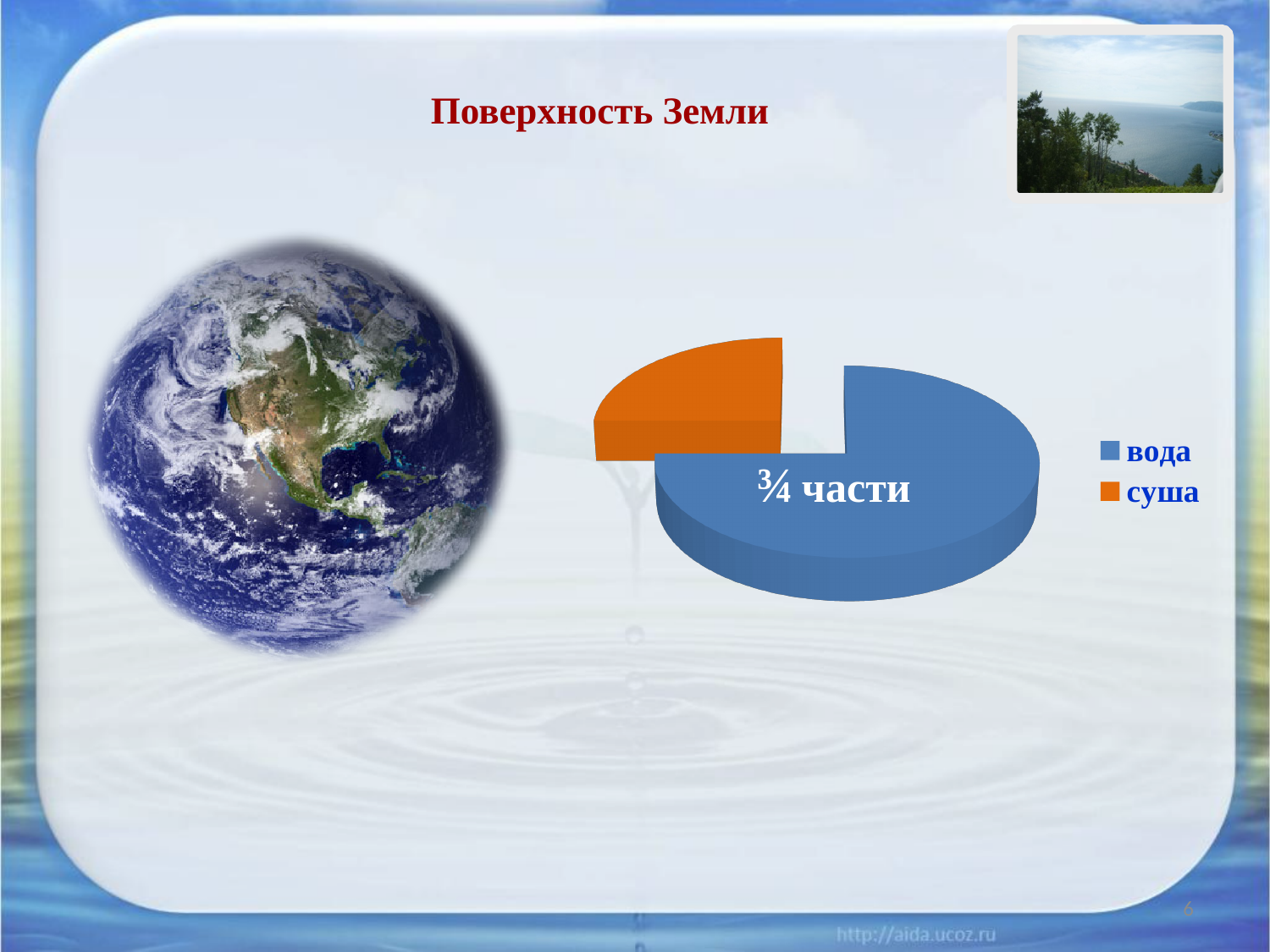
What kind of chart is shown on the slide? pie chart What colour is the суша slice in the pie chart? orange Which category has the smallest slice in the pie chart? суша How many entries does the legend of the pie chart list? 2 Which slice is larger in the pie chart, вода or суша? вода Which category has the largest slice in the pie chart? вода How many slices does the pie chart have? 2 What share of the pie does the вода slice represent, according to the label on the slide? ¾ части What label is printed on the вода slice of the pie chart? ¾ части What is the title of the chart on the slide? Поверхность Земли